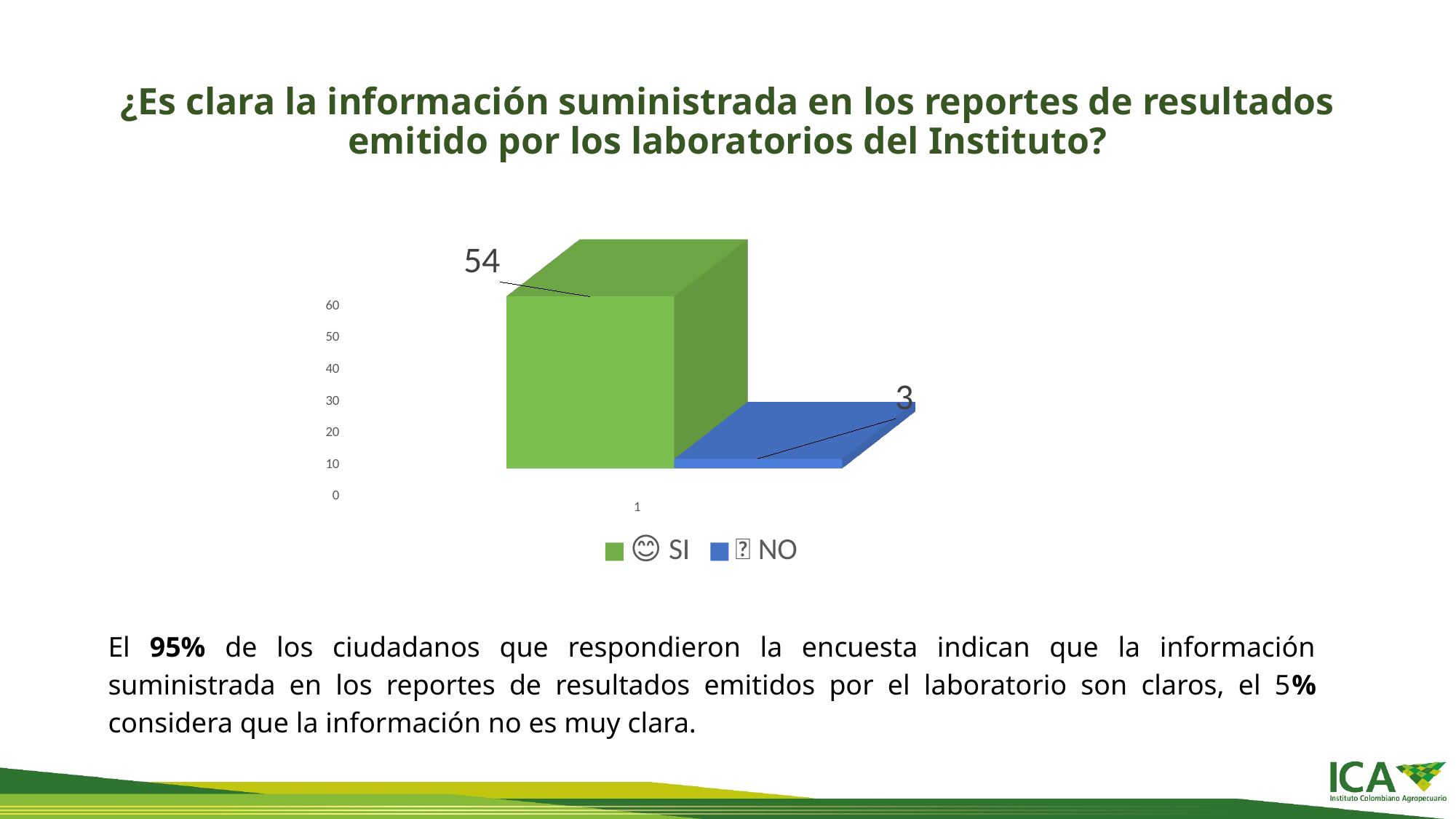
What kind of chart is shown on the slide? bar chart Is the value for NO greater or less than 10? less What is the highest value shown on the vertical axis? 60 Which series has the highest value? SI What is the value for SI? 54 How many series does the legend list? 2 Which series has the lowest value? NO What colour is the bar for SI? green What is the difference between the SI and NO values? 51 Is the value for SI greater or less than 50? greater What is the value for NO? 3 Which is larger, the value for SI or the value for NO? SI